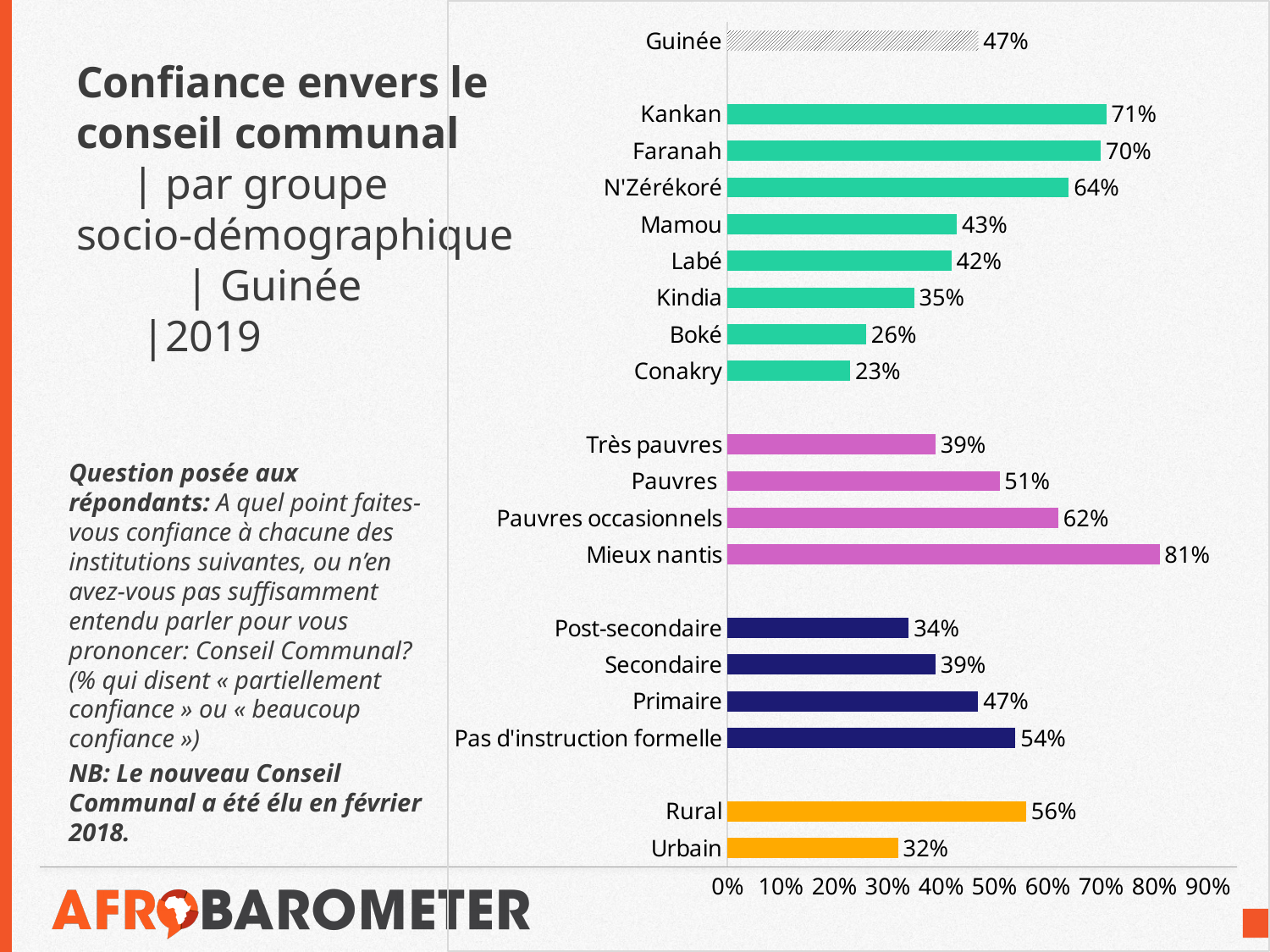
Which is larger, the value for Faranah or the value for N'Zérékoré? Faranah Which category has the lowest value on the chart? Conakry How many categories are plotted on the chart? 19 What kind of chart is shown on the slide? Bar chart Which category has the highest value on the chart? Mieux nantis What is the value for Mieux nantis? 81% Is the value for Pas d'instruction formelle greater or less than 50%? greater What is the difference between Rural and Urbain? 24 percentage points What is the difference between Mieux nantis and Très pauvres? 42 percentage points What is the value for Guinée overall? 47% What is the value for Kankan? 71% What is the value for Urbain? 32%